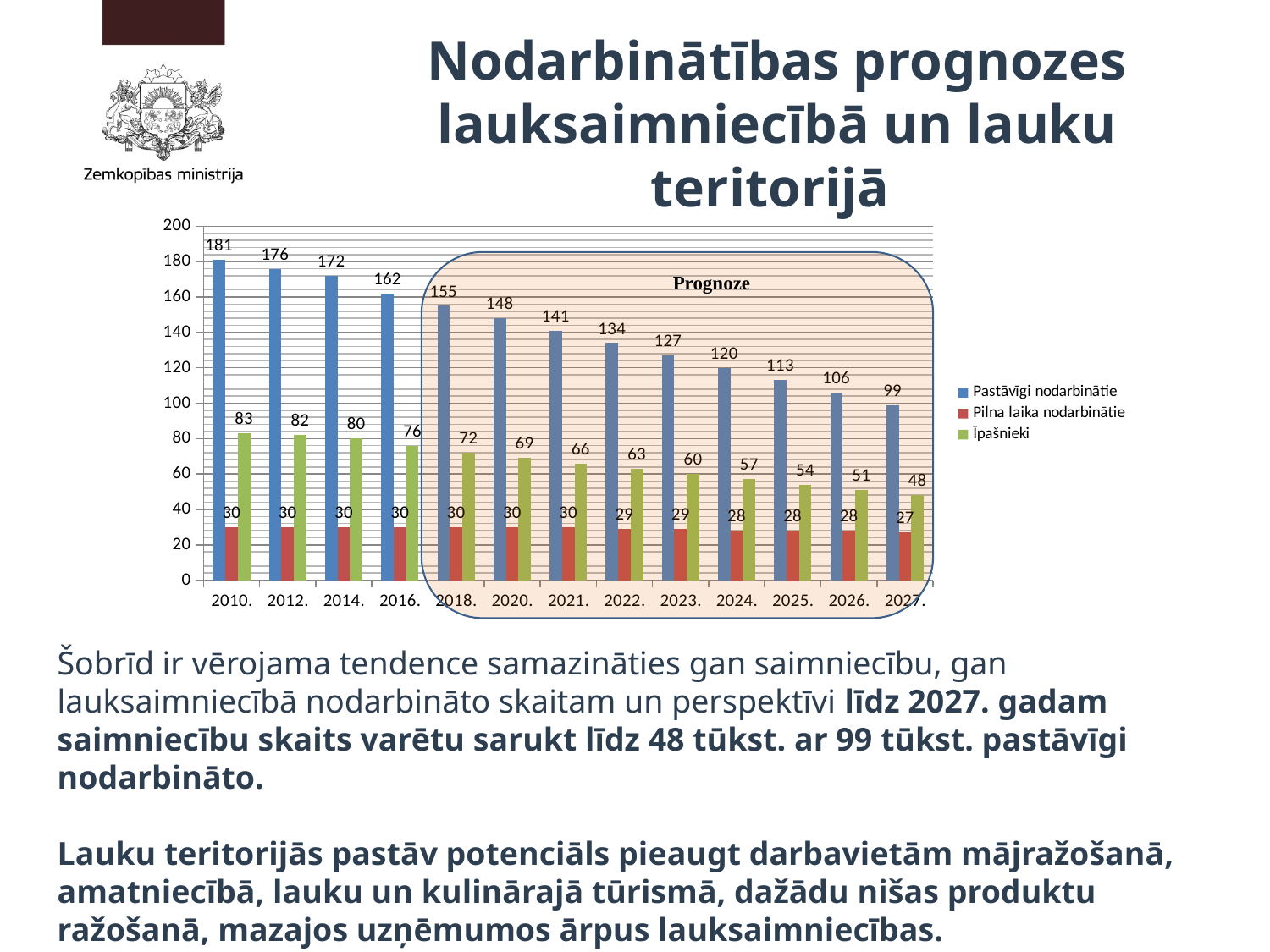
In which year is the value for Īpašnieki the highest? 2010. Which is larger: Īpašnieki in 2018. or Īpašnieki in 2023.? 2018. Do the values for Pastāvīgi nodarbinātie rise or fall from 2010. to 2027.? fall Is the value for Pastāvīgi nodarbinātie in 2022. greater or less than 140? less What is the value for Pilna laika nodarbinātie in 2024.? 28 How many years are shown on the x axis? 13 What is the value for Īpašnieki in 2027.? 48 In which year is the value for Pastāvīgi nodarbinātie the lowest? 2027. What is the difference between the Pastāvīgi nodarbinātie values for 2010. and 2027.? 82 How many series does the legend list? 3 What is the value for Pastāvīgi nodarbinātie in 2010.? 181 What kind of chart is shown on the slide? bar chart